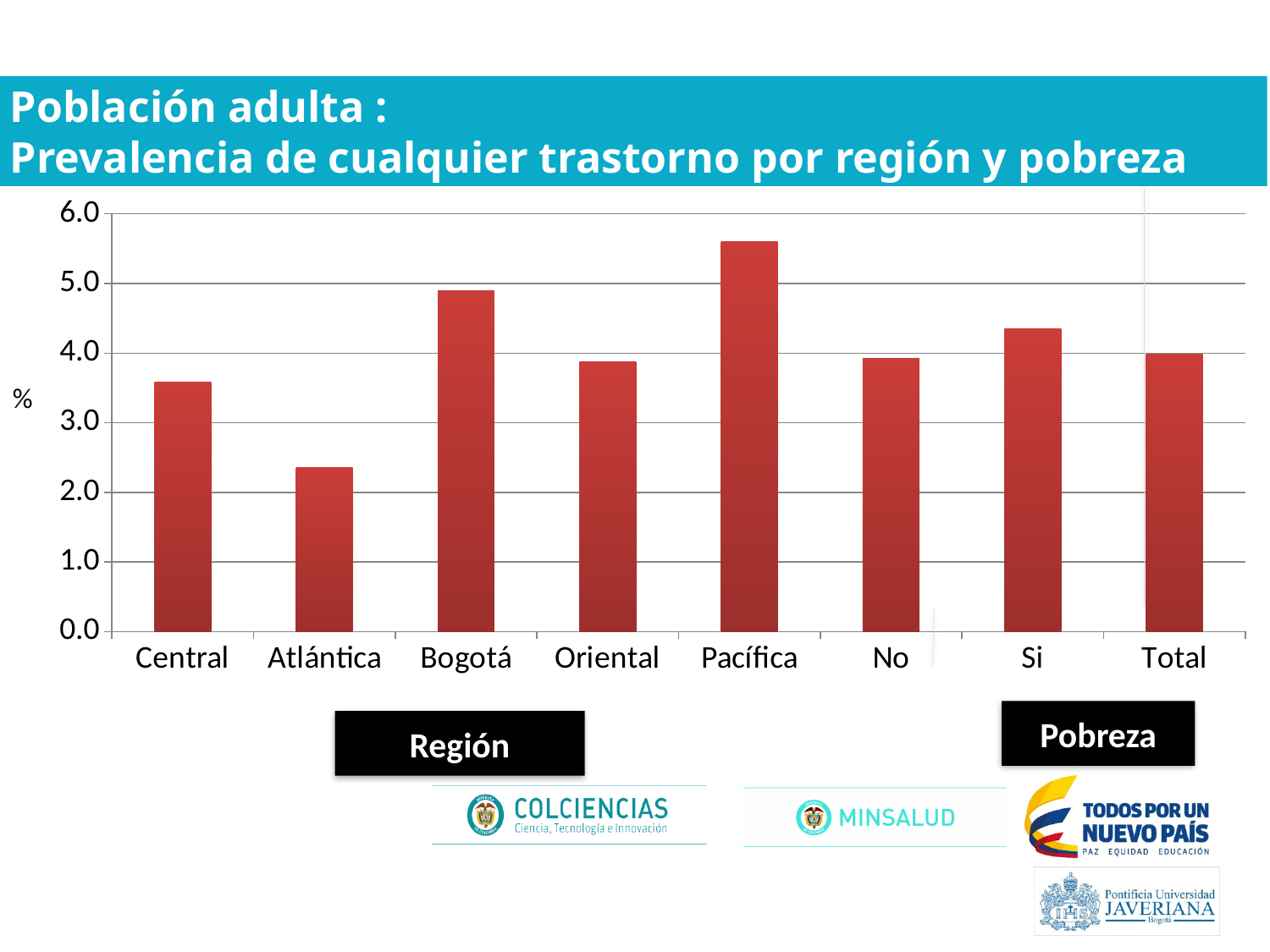
Which category has the lowest bar in the chart? Atlántica Which is larger, the value for Bogotá or the value for Central? Bogotá Which category has the highest bar in the chart? Pacífica How many bars (categories) are plotted in the chart? 8 Is the value for Pacífica greater or less than 5.0? greater What unit is shown on the vertical axis label of the chart? % Is the value for Atlántica greater or less than 3.0? less What kind of chart is shown on the slide? bar chart Is the value for Central greater or less than 4.0? less Which is larger, the value for Si or the value for No? Si